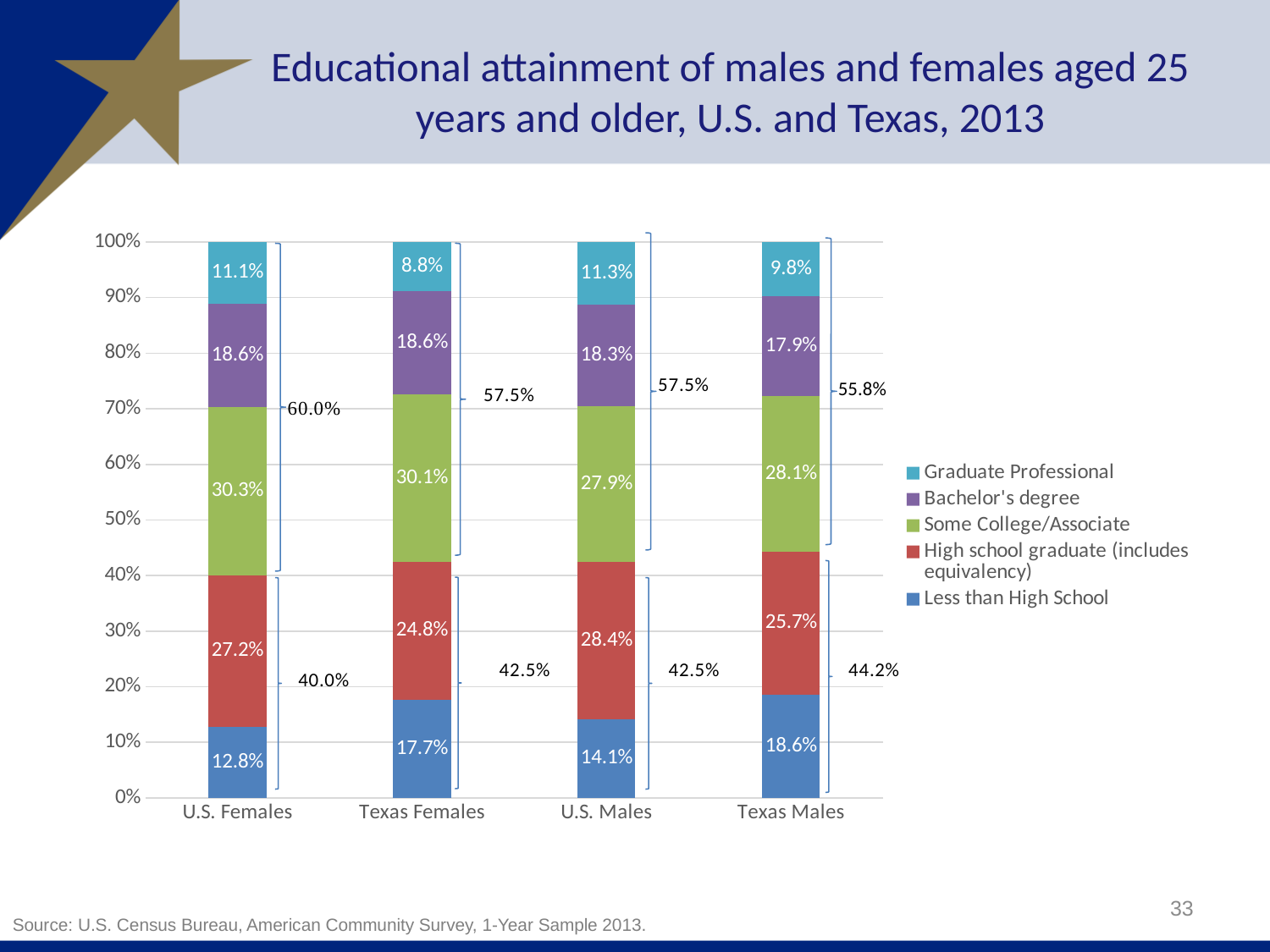
What is the Some College/Associate value for U.S. Males? 27.9% How many categories are shown on the x axis? 4 What is the difference between the High school graduate shares of U.S. Males and Texas Females? 3.6% Which is larger, the Less than High School share for U.S. Females or for U.S. Males? U.S. Males What percentage of U.S. Females have less than a high school education? 12.8% What is the Graduate Professional share for Texas Females? 8.8% What kind of chart is shown on the slide? Stacked bar chart How many series does the legend list? 5 Which category has the highest Less than High School share? Texas Males What is the combined share of Some College/Associate, Bachelor's degree and Graduate Professional for U.S. Females, as labelled by the bracket? 60.0% What is the Bachelor's degree share for Texas Males? 17.9% Which category has the lowest Graduate Professional share? Texas Females